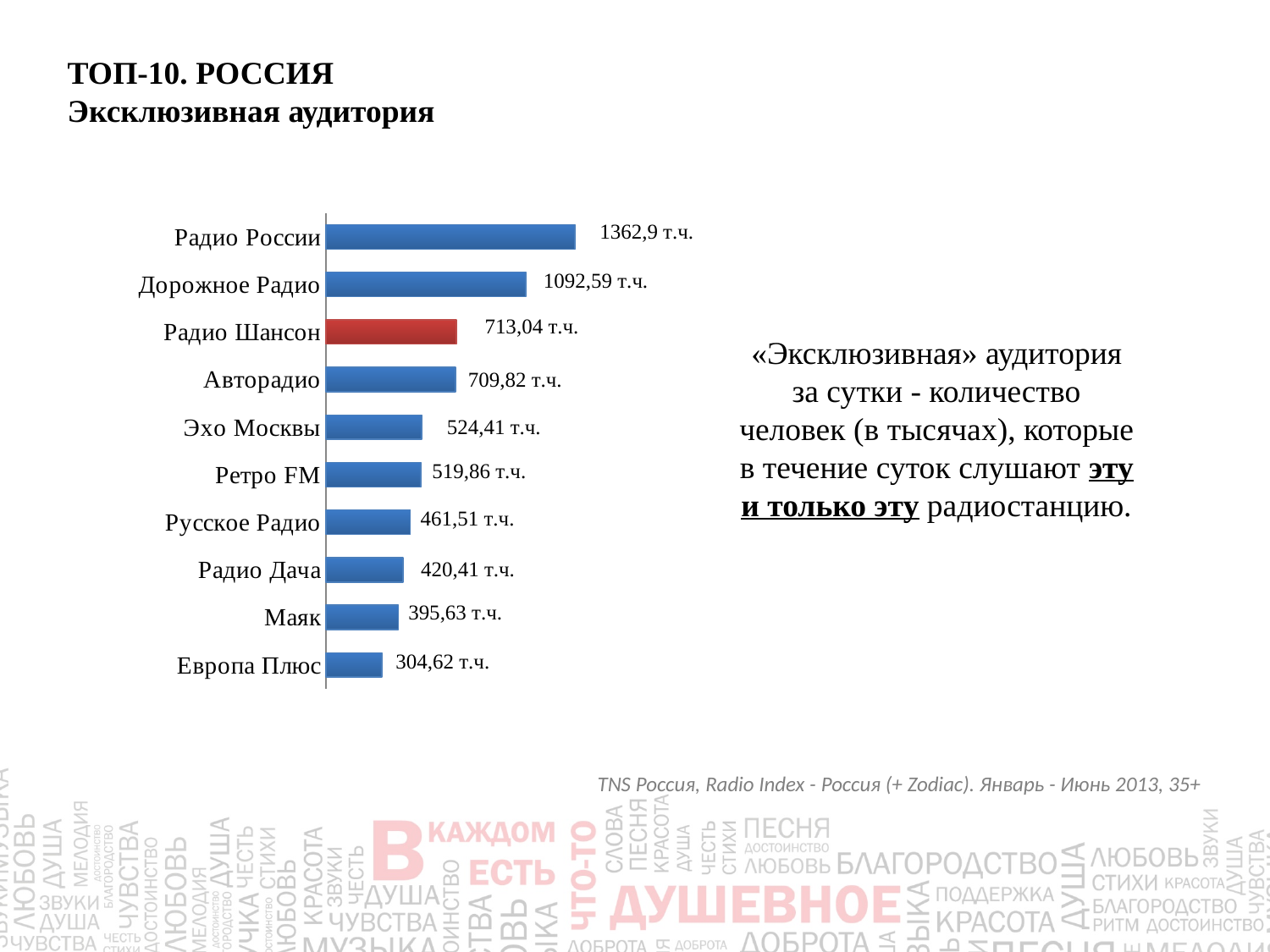
What is the title of the slide? ТОП-10. РОССИЯ Эксклюзивная аудитория Which has a larger value, Русское Радио or Радио Дача? Русское Радио How many radio stations are shown on the chart? 10 What kind of chart is shown on the slide? Bar chart What is the exclusive audience value shown for Радио России? 1362,9 т.ч. What value is shown for Маяк? 395,63 т.ч. Which radio station's bar is coloured red instead of blue? Радио Шансон What value is shown for Эхо Москвы? 524,41 т.ч. What is the difference between the values for Радио России and Дорожное Радио? 270,31 т.ч. Which radio station has the highest exclusive audience on the chart? Радио России Which radio station has the lowest exclusive audience on the chart? Европа Плюс What is the difference between the values for Радио Шансон and Авторадио? 3,22 т.ч.